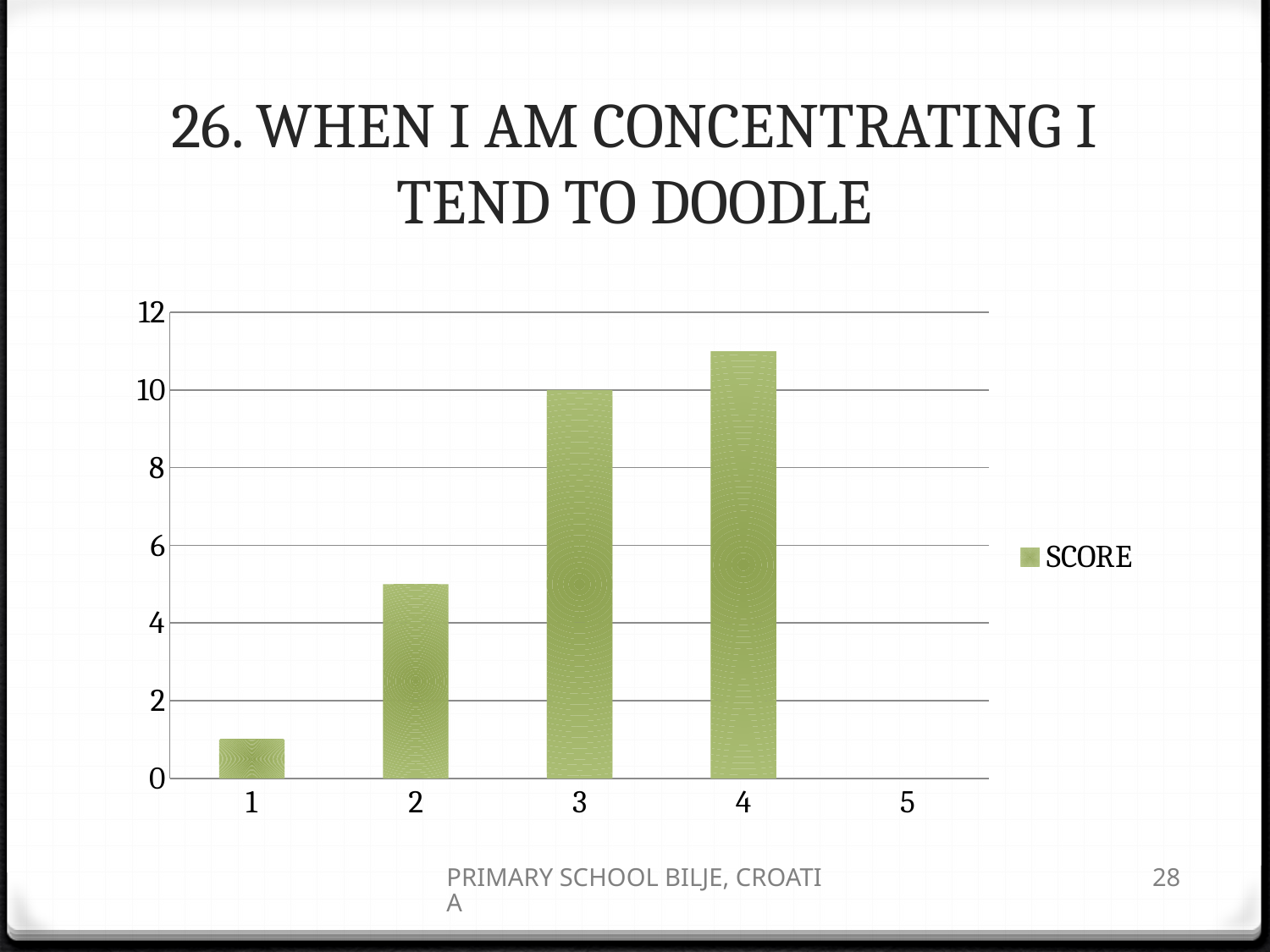
What is the name of the series shown in the legend? SCORE What is the value for category 3? 10 How many series does the legend list? 1 Which has the larger value, category 2 or category 3? 3 Which category has the highest value? 4 Is the value for category 2 greater or less than 4? greater Is the value for category 4 greater or less than 10? greater What is the value for category 5? 0 What kind of chart is shown on the slide? bar chart How many categories are shown on the x axis? 5 Which category has the lowest value? 5 Is the value for category 1 greater or less than 2? less